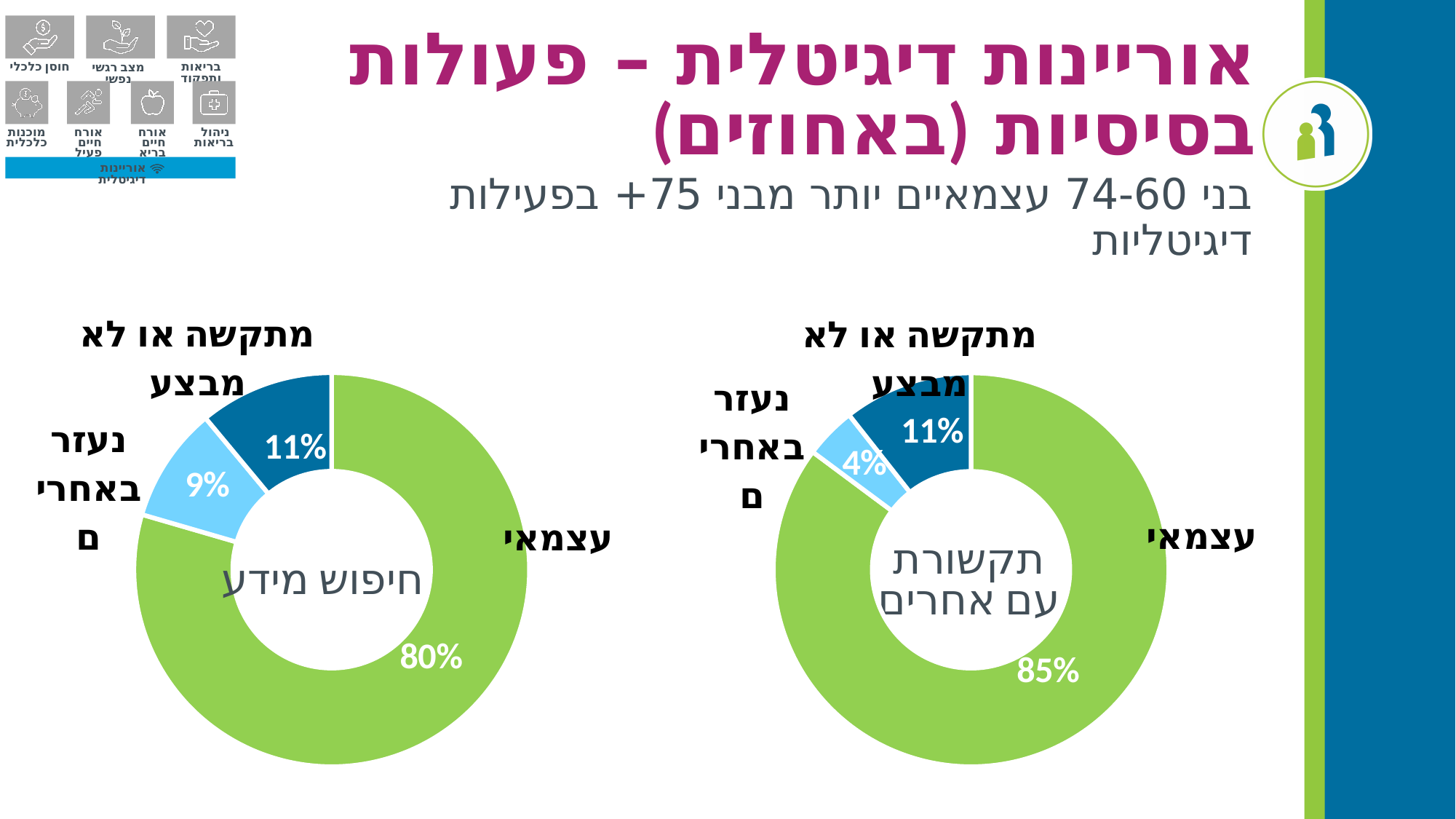
What type of chart is the left chart titled "חיפוש מידע"? Donut (pie) chart How many categories does the right chart titled "תקשורת עם אחרים" show? 3 In the right chart titled "תקשורת עם אחרים", what percentage is shown for "נעזר באחרים"? 4% In the right chart titled "תקשורת עם אחרים", what percentage is shown for "עצמאי"? 85% In the left chart titled "חיפוש מידע", what is the difference between "מתקשה או לא מבצע" and "נעזר באחרים"? 2% What is the difference between the "עצמאי" share in the right chart ("תקשורת עם אחרים") and the "עצמאי" share in the left chart ("חיפוש מידע")? 5% In the left chart titled "חיפוש מידע", which category has the largest share? עצמאי In the left chart titled "חיפוש מידע", which is larger: "נעזר באחרים" or "מתקשה או לא מבצע"? מתקשה או לא מבצע In the left chart titled "חיפוש מידע", what percentage is shown for "מתקשה או לא מבצע"? 11% In the left chart titled "חיפוש מידע", what percentage is shown for "עצמאי"? 80% What colour is the "עצמאי" slice in both charts? Green In the right chart titled "תקשורת עם אחרים", which category has the smallest share? נעזר באחרים